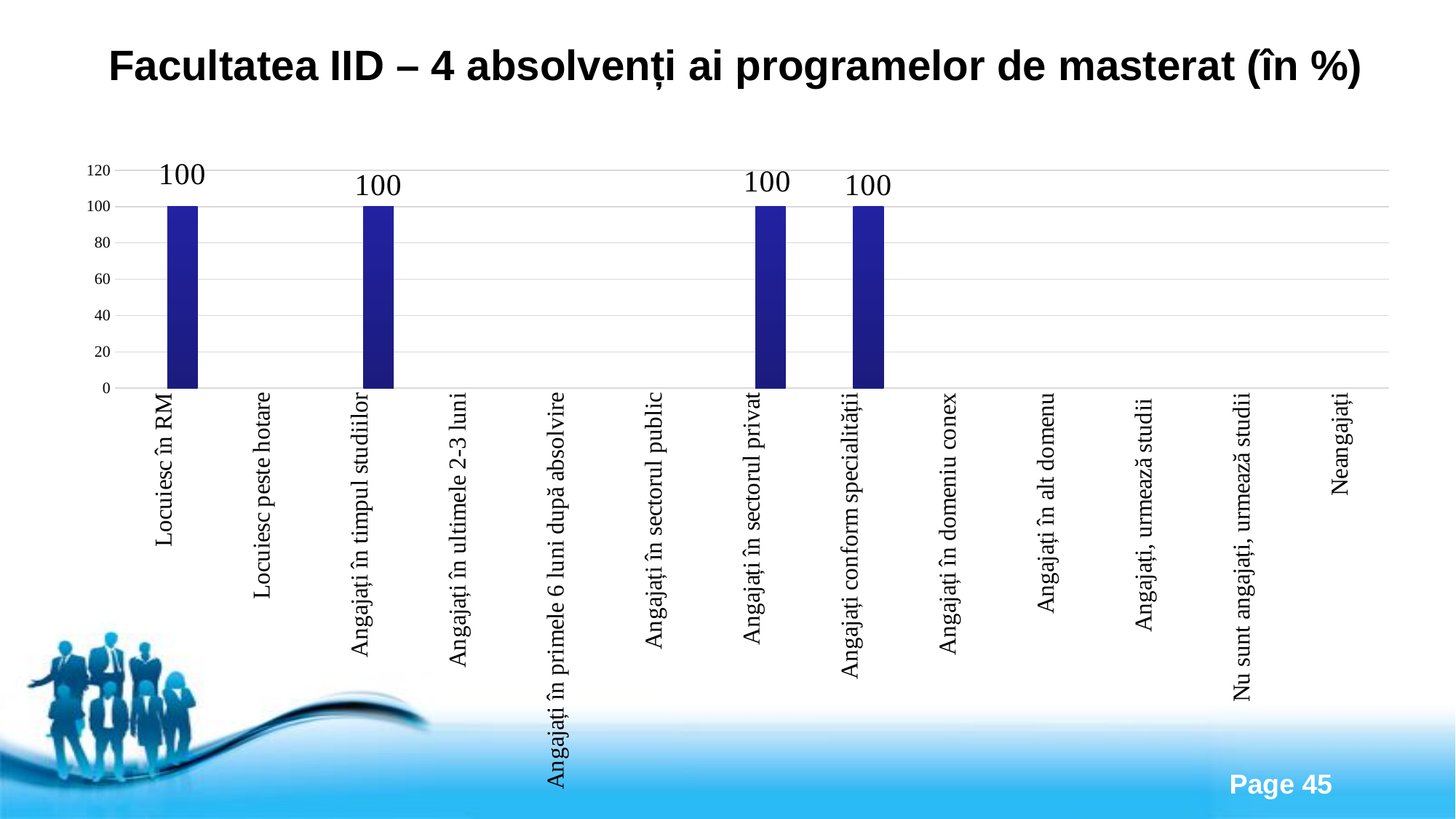
How many categories are listed on the x axis of the chart? 13 How many bars with a data label are shown in the chart? 4 Is the value for "Angajați în sectorul privat" greater or less than 80? greater What is the value for "Angajați în timpul studiilor"? 100 What is the highest value shown on the vertical axis of the chart? 120 Which is larger, the value for "Locuiesc în RM" or the value for "Locuiesc peste hotare"? Locuiesc în RM What is the value for "Angajați în sectorul privat"? 100 What is the value for "Locuiesc în RM"? 100 What is the value for "Angajați conform specialității"? 100 What kind of chart is shown on the slide? bar chart What is the title of the slide containing the chart? Facultatea IID – 4 absolvenți ai programelor de masterat (în %) Is the value for "Locuiesc în RM" greater or less than 120? less